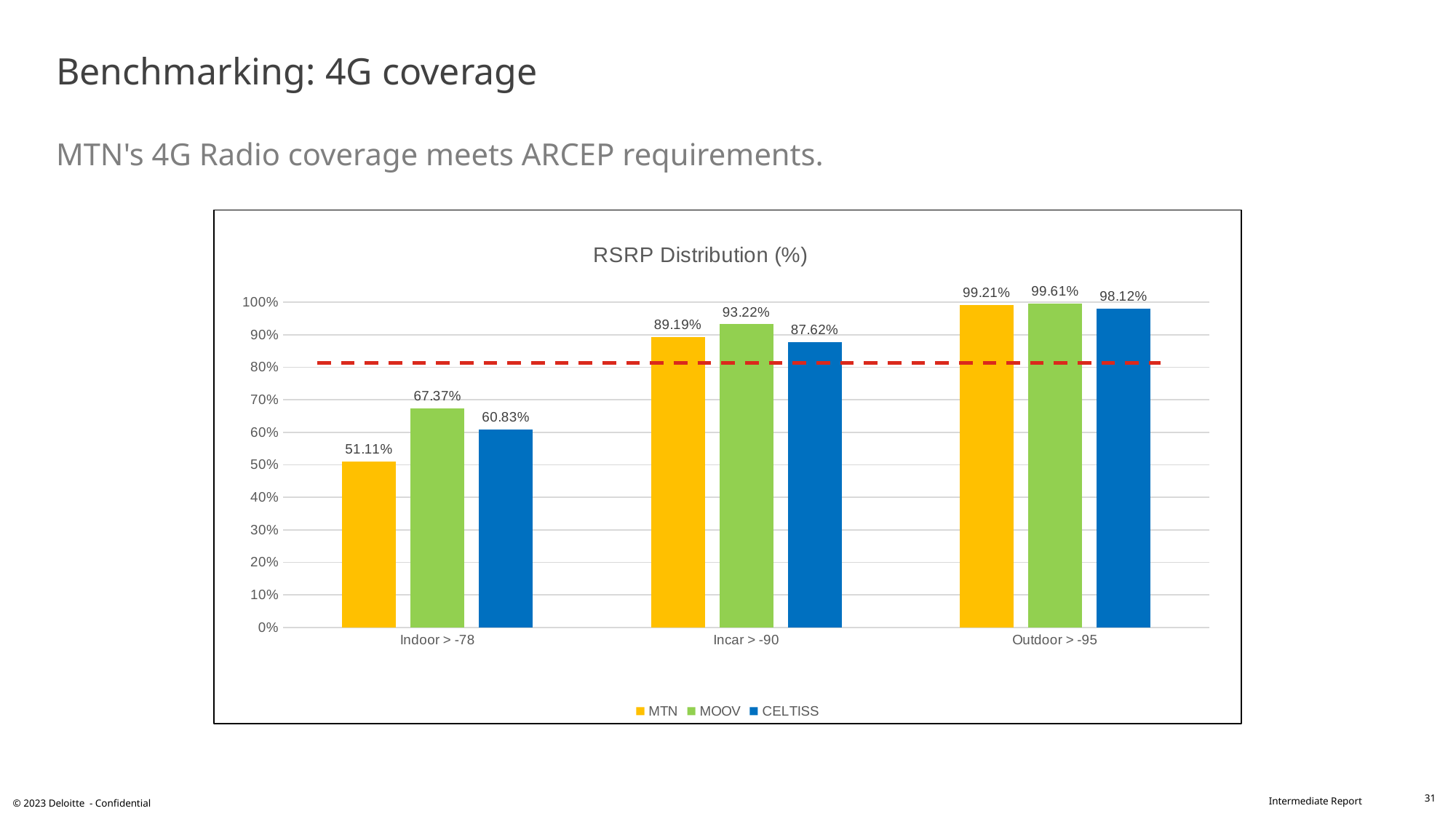
What is the value for CELTISS in the Incar > -90 category? 87.62% What is the title of the chart? RSRP Distribution (%) How many series does the legend list? 3 What kind of chart is shown on the slide? bar chart Is the value for MTN in the Indoor > -78 category greater or less than 60%? less Which operator has the highest value in the Indoor > -78 category? MOOV What is the value for MOOV in the Outdoor > -95 category? 99.61% How many categories are shown on the x axis? 3 Which is larger: MTN's value for Incar > -90 or CELTISS's value for Incar > -90? MTN What is the value for MTN in the Indoor > -78 category? 51.11% Which operator has the lowest value in the Incar > -90 category? CELTISS What is the difference between MOOV and MTN in the Indoor > -78 category? 16.26%